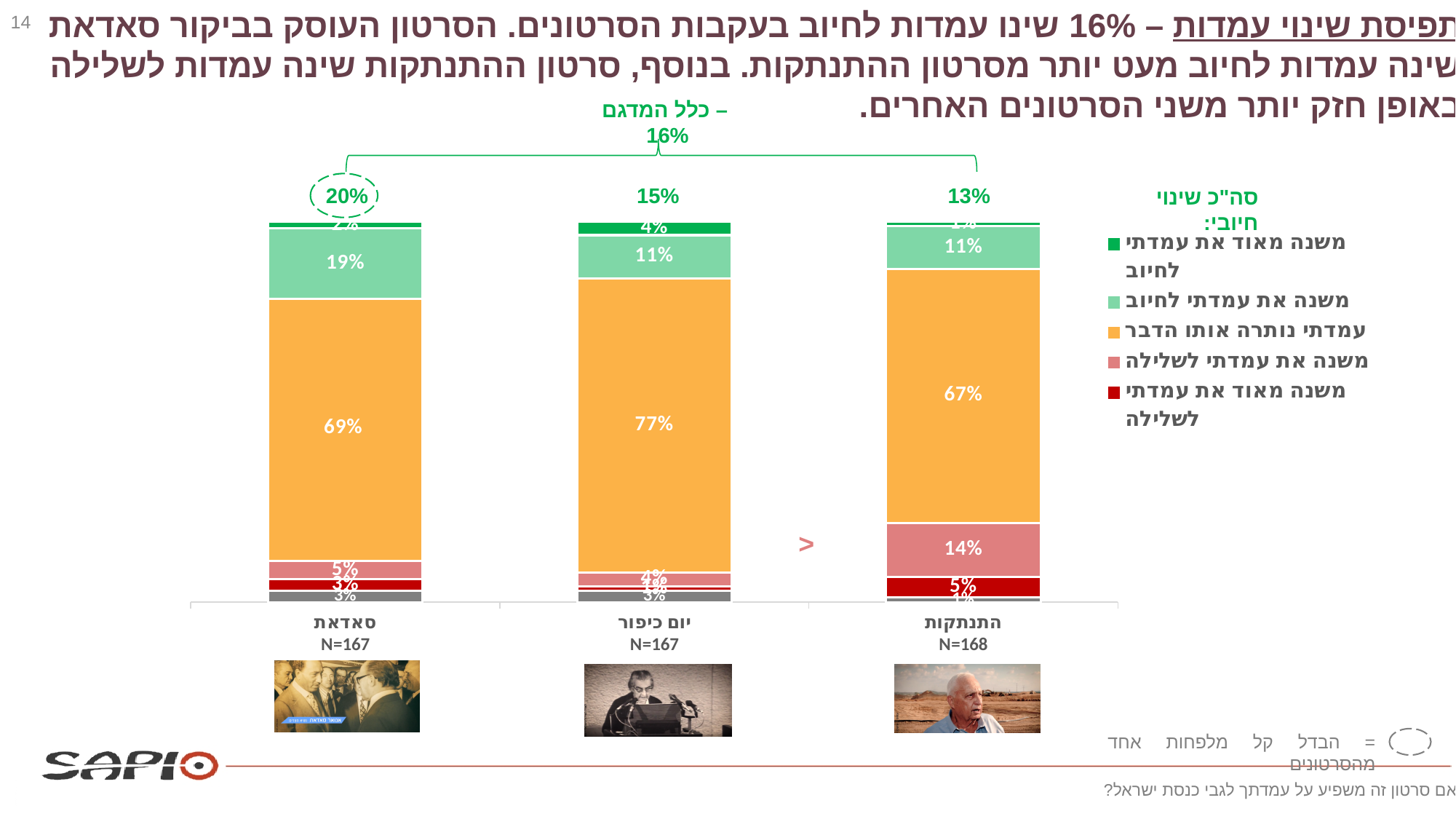
Which is larger: the pink segment (משנה את עמדתי לשלילה) for התנתקות or for סאדאת? התנתקות What is the value of the orange segment (עמדתי נותרה אותו הדבר) for סאדאת? 69% What is the value of the light green segment (משנה את עמדתי לחיוב) for סאדאת? 19% Which category has the lowest total positive change shown above its bar? התנתקות What is the total positive change (סה"כ שינוי חיובי) shown above the סאדאת bar? 20% Which category has the highest total positive change shown above its bar? סאדאת What is the value of the orange segment (עמדתי נותרה אותו הדבר) for יום כיפור? 77% What is the value of the pink segment (משנה את עמדתי לשלילה) for התנתקות? 14% How many series does the legend list? 5 How many categories (bars) does the chart show? 3 What kind of chart is shown on the slide? stacked bar chart What is the difference between the orange segment values for יום כיפור and סאדאת? 8%